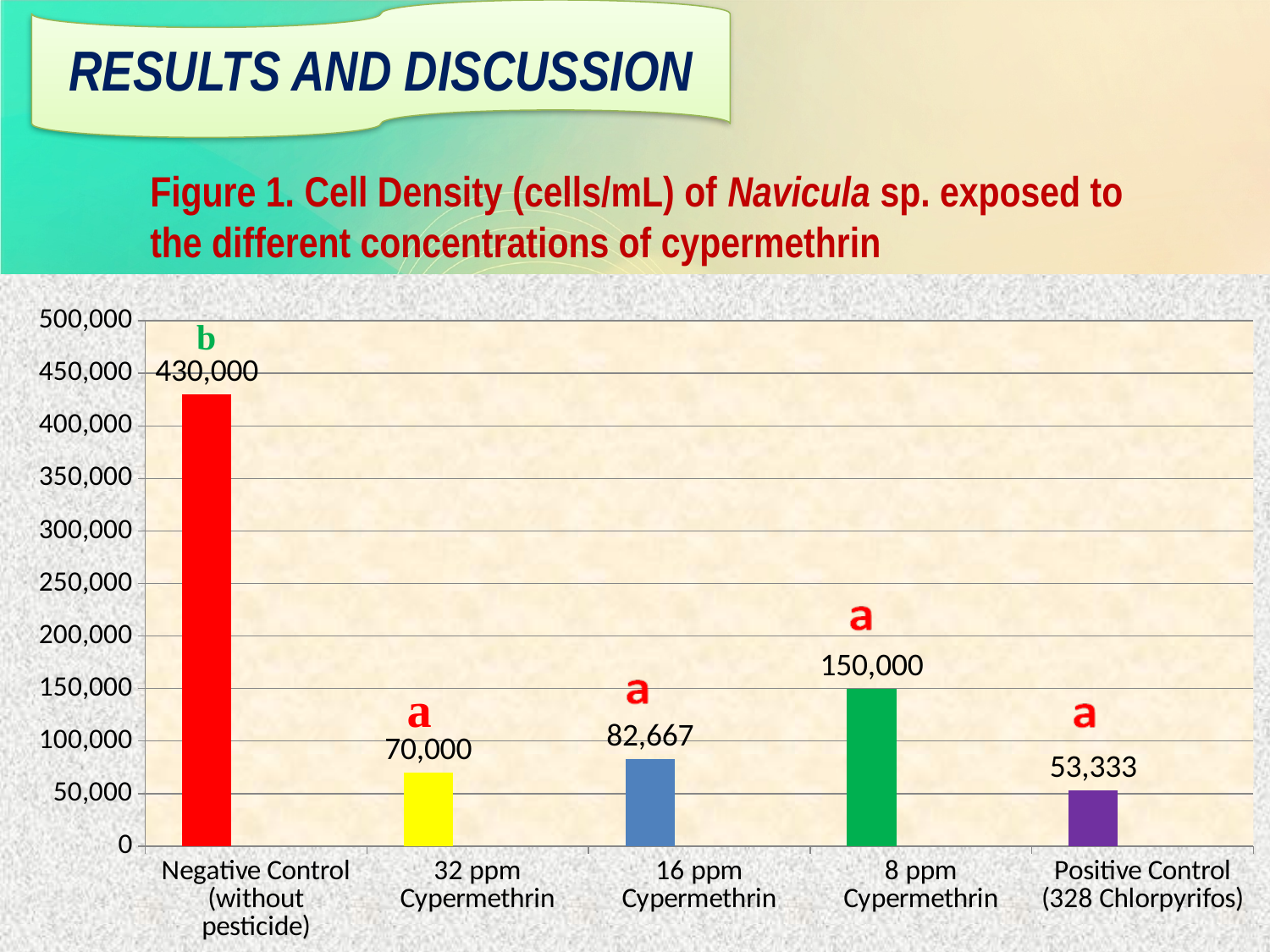
What is the cell density for the Positive Control (328 Chlorpyrifos)? 53,333 What is the cell density for 16 ppm Cypermethrin? 82,667 What colour is the bar for 8 ppm Cypermethrin? green What is the difference in cell density between 8 ppm Cypermethrin and 32 ppm Cypermethrin? 80,000 Which treatment has the highest cell density? Negative Control (without pesticide) Which treatment has the lowest cell density? Positive Control (328 Chlorpyrifos) What is the cell density for the Negative Control (without pesticide)? 430,000 How many treatment categories are shown on the chart? 5 Which has a higher cell density, 16 ppm Cypermethrin or 8 ppm Cypermethrin? 8 ppm Cypermethrin What kind of chart is shown on the slide? bar chart Which treatment is labelled with the letter 'b' above its bar? Negative Control (without pesticide) Is the cell density for 32 ppm Cypermethrin greater or less than 100,000? less